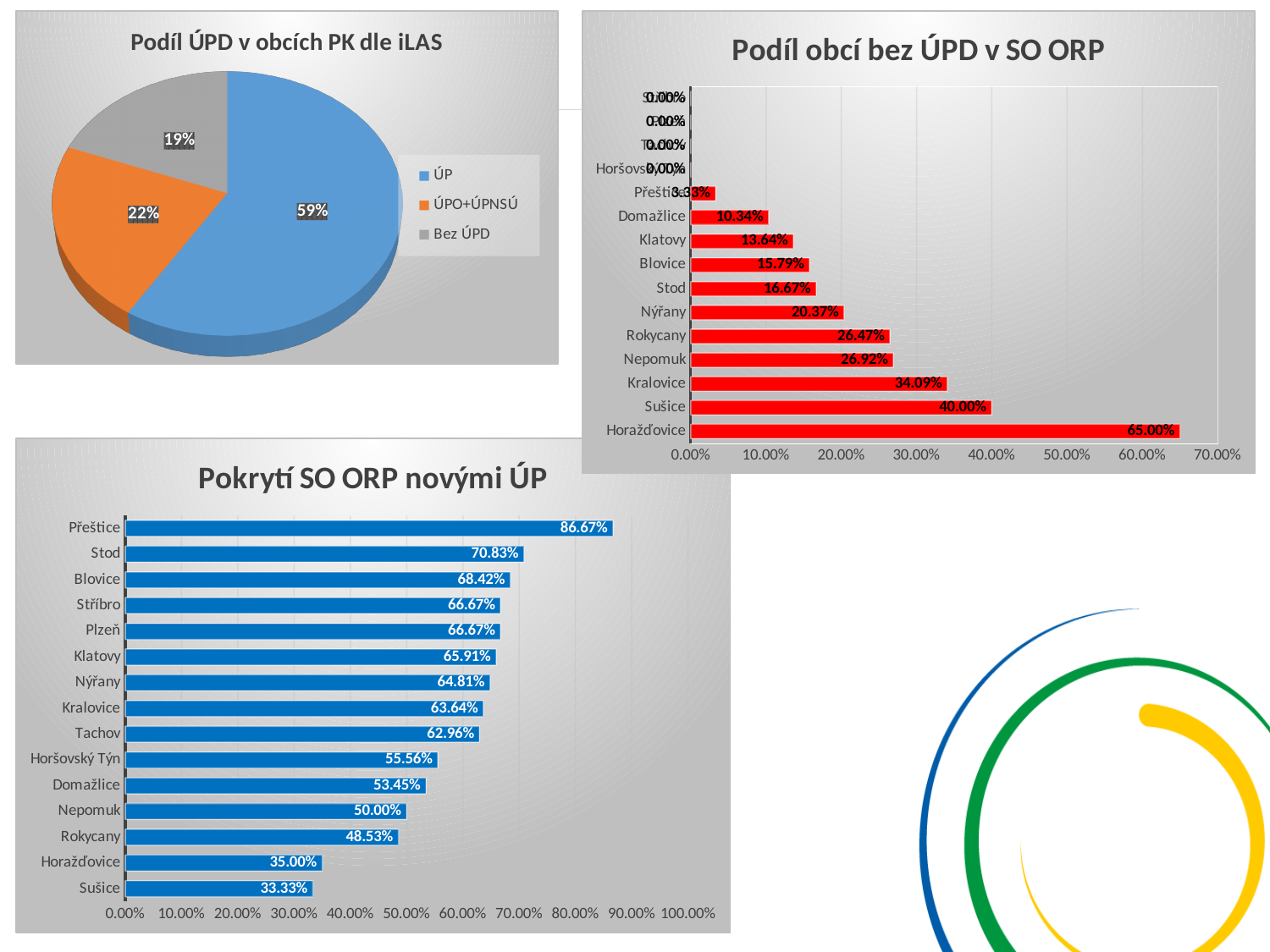
How many categories are shown in the chart 'Pokrytí SO ORP novými ÚP'? 15 In the chart 'Podíl ÚPD v obcích PK dle iLAS', what share does Bez ÚPD have? 19% In the chart 'Pokrytí SO ORP novými ÚP', which category has the lowest value? Sušice How many entries does the legend of 'Podíl ÚPD v obcích PK dle iLAS' list? 3 In the chart 'Podíl ÚPD v obcích PK dle iLAS', what share does ÚP have? 59% In the chart 'Podíl obcí bez ÚPD v SO ORP', what is the value for Nýřany? 20.37% In the chart 'Podíl obcí bez ÚPD v SO ORP', what is the value for Horažďovice? 65.00% What kind of chart is 'Podíl ÚPD v obcích PK dle iLAS'? pie chart In the chart 'Pokrytí SO ORP novými ÚP', which is larger, Stod or Blovice? Stod In the chart 'Podíl obcí bez ÚPD v SO ORP', what is the difference between Sušice and Kralovice? 5.91% In the chart 'Podíl obcí bez ÚPD v SO ORP', which category has the highest value? Horažďovice In the chart 'Pokrytí SO ORP novými ÚP', what is the value for Přeštice? 86.67%